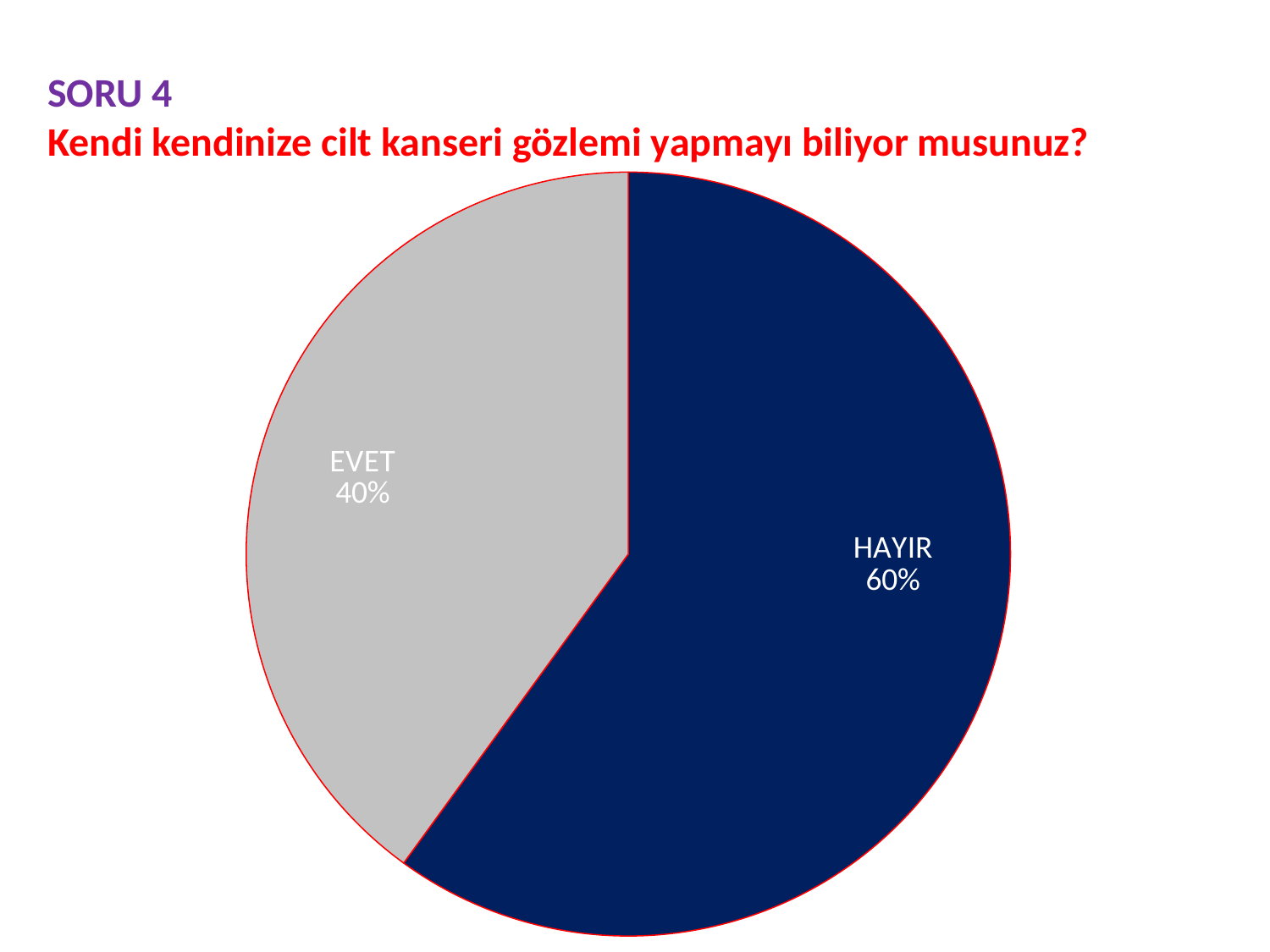
What kind of chart is shown on the slide? Pie chart What percentage of respondents answered HAYIR? 60% What colour is the HAYIR slice? Dark blue Which response has the smallest share of the pie? EVET How many slices does the pie chart have? 2 What share of the pie does the EVET slice represent? 40% Which is larger, the share for EVET or the share for HAYIR? HAYIR What is the difference in percentage points between HAYIR and EVET? 20 What percentage of respondents answered EVET? 40% What question does the chart on the slide answer? Kendi kendinize cilt kanseri gözlemi yapmayı biliyor musunuz? Which response has the largest share of the pie? HAYIR